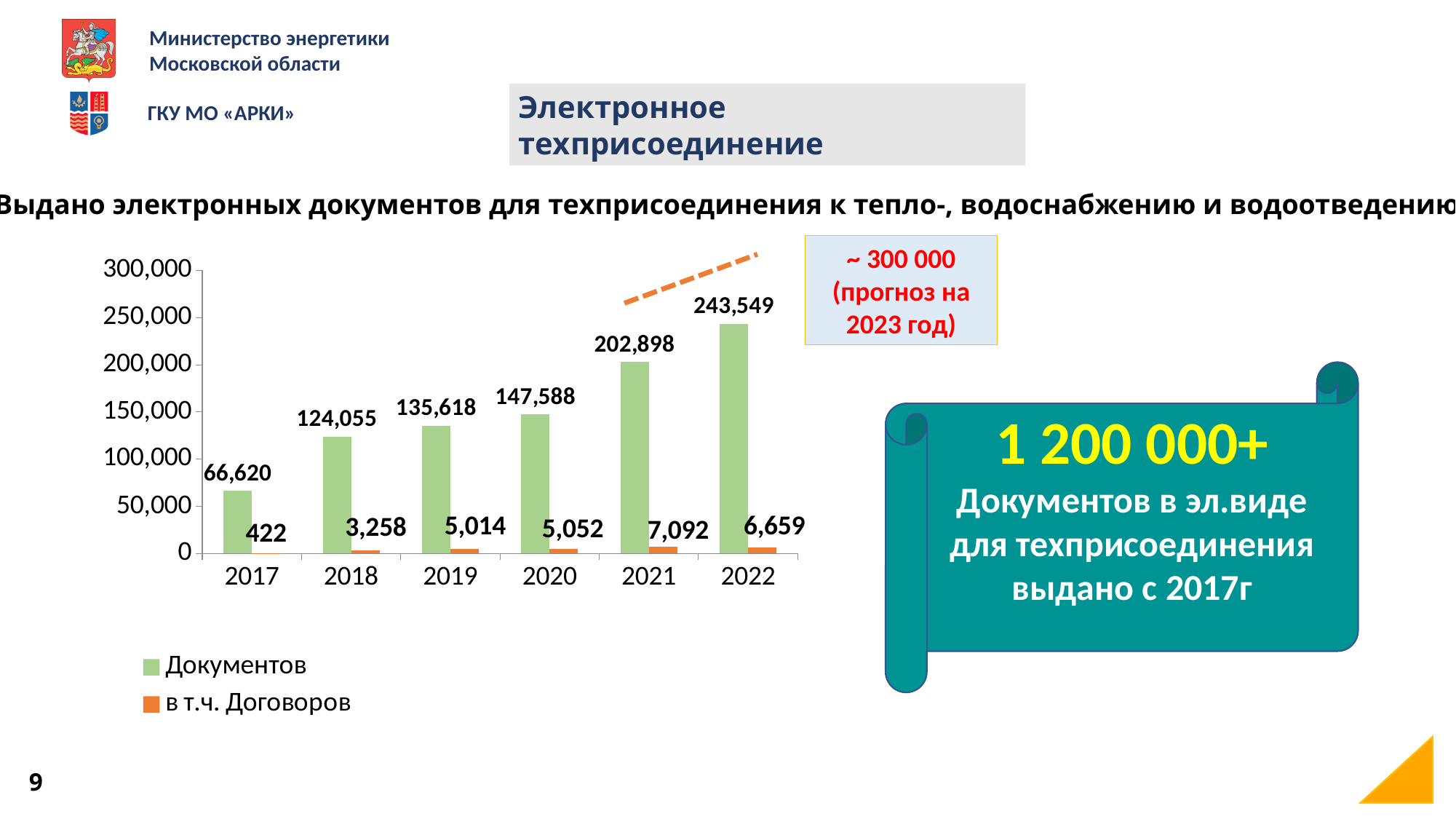
What kind of chart is shown? Bar chart What is the value of Документов for 2019? 135,618 How many years are shown on the x axis? 6 What is the value of в т.ч. Договоров for 2017? 422 What is the value of Документов for 2022? 243,549 Which year has the highest value of Документов? 2022 Which year has the lowest value of в т.ч. Договоров? 2017 What is the value of в т.ч. Договоров for 2021? 7,092 How many series does the legend list? 2 What is the difference between the Документов values for 2022 and 2021? 40,651 Which is larger, the в т.ч. Договоров value for 2021 or for 2022? 2021 Do the Документов values rise or fall from 2017 to 2022? Rise